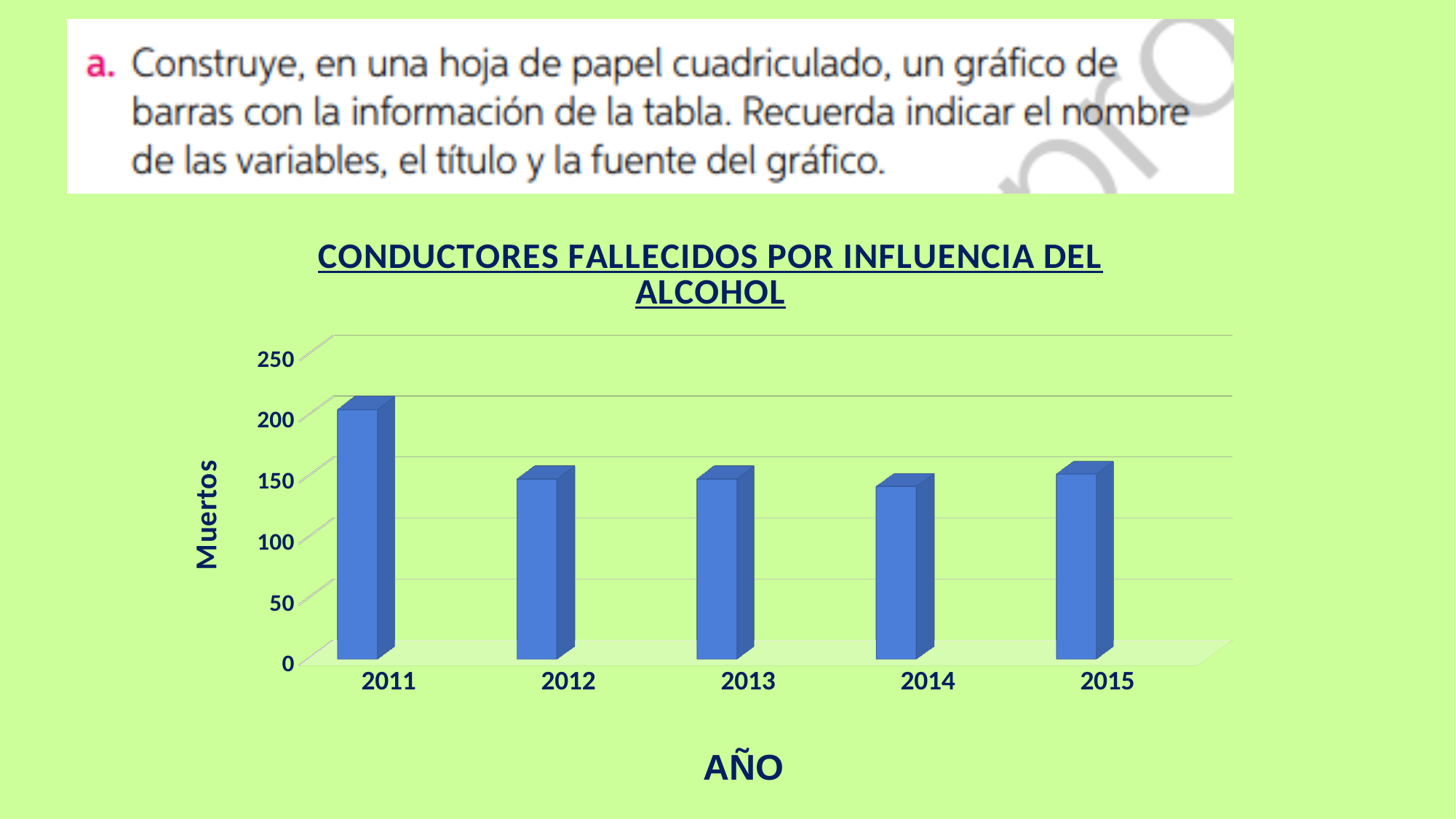
Which year has the highest number of deaths in the chart? 2011 What is the title of the chart? CONDUCTORES FALLECIDOS POR INFLUENCIA DEL ALCOHOL Is the value for 2011 greater or less than 150? greater Which is larger, the value for 2011 or the value for 2013? 2011 Which is larger, the value for 2011 or the value for 2015? 2011 How many years are shown on the x axis of the chart? 5 What kind of chart is shown on the slide? Bar chart What is the label of the vertical axis of the chart? Muertos Is the value for 2012 greater or less than 200? less Is the value for 2014 greater or less than 100? greater